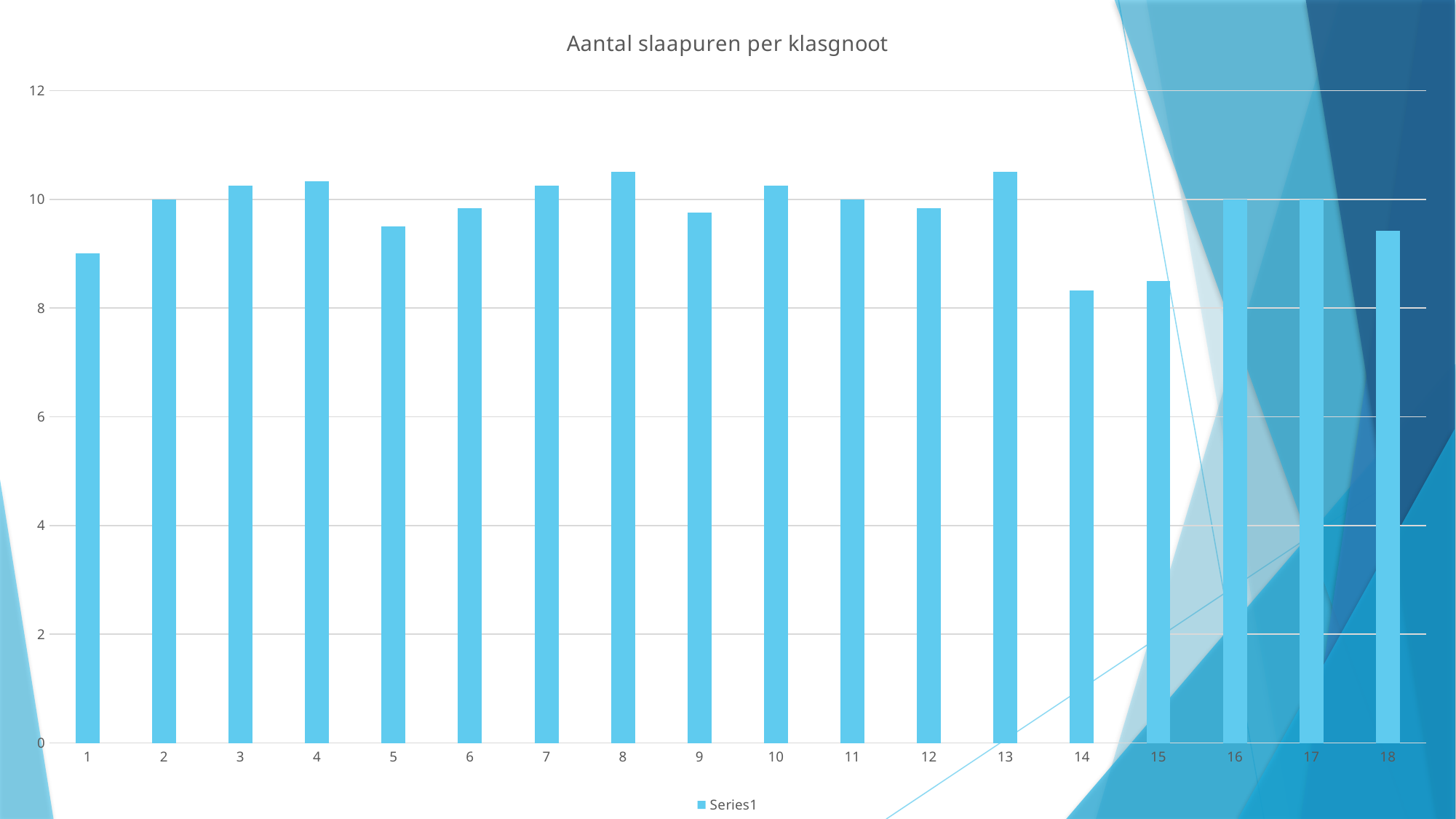
Is the value for category 8 greater or less than 10? greater What is the value for category 2? 10 Is the value for category 5 greater or less than 10? less What is the value for category 11? 10 Which is larger, the value for category 4 or the value for category 5? category 4 Is the value for category 1 greater or less than 8? greater What kind of chart is shown on the slide? bar chart What is the value for category 17? 10 How many categories (klasgenoten) are shown on the x axis? 18 How many series does the legend list? 1 What is the title of the chart? Aantal slaapuren per klasgnoot Which is larger, the value for category 14 or the value for category 1? category 1